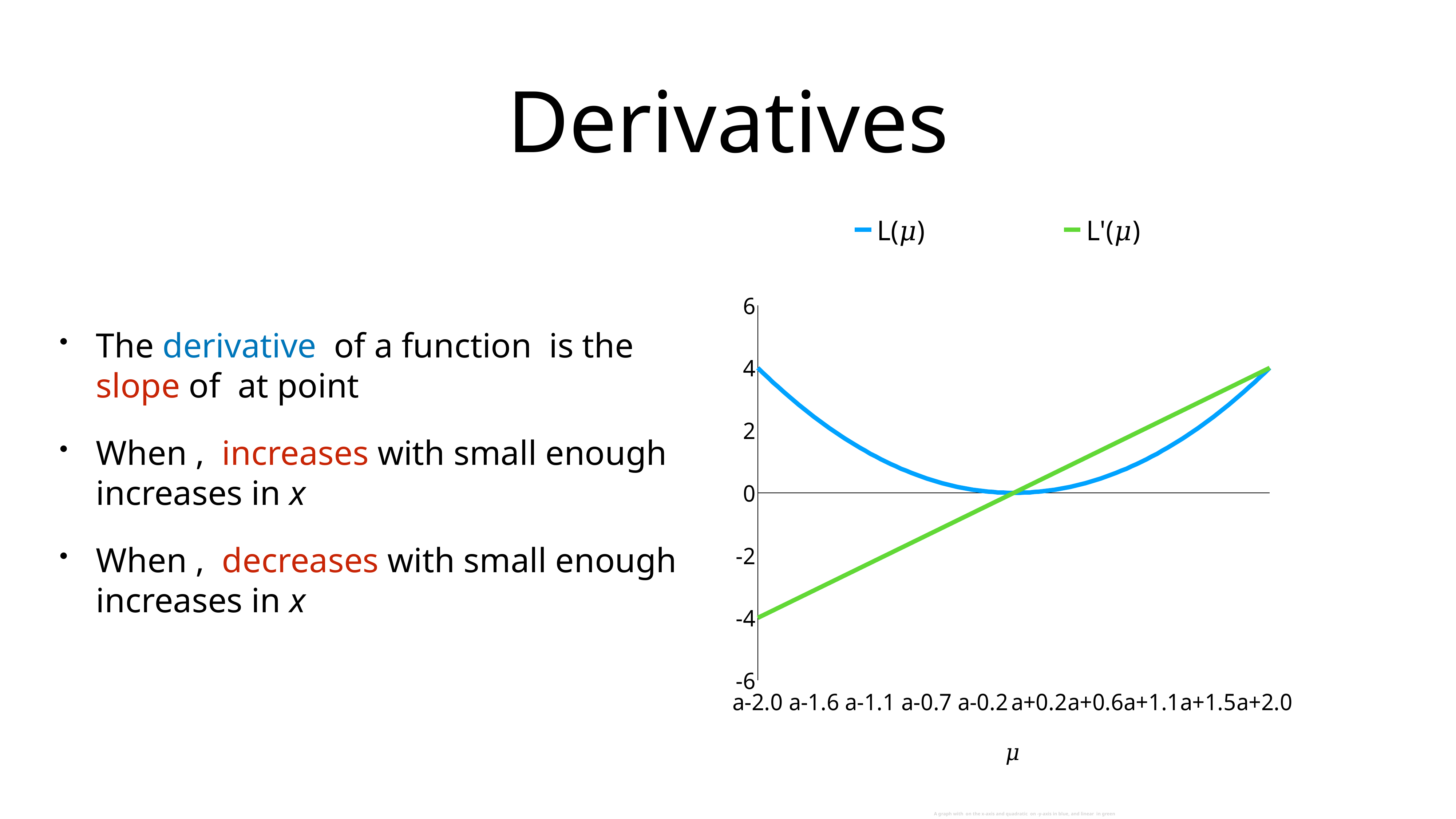
What kind of chart is shown on the slide? line chart What is the value of L'(μ) at a-2.0? -4 Is the value of L'(μ) at a-1.1 greater or less than 0? less What is the value of L'(μ) at a+2.0? 4 What colour is the L(μ) line? blue At a-2.0, which is larger, L(μ) or L'(μ)? L(μ) What is the difference between L(μ) and L'(μ) at a-2.0? 8 Does L'(μ) rise or fall as μ increases along the x axis? rises How many series does the legend list? 2 What is the value of L(μ) at a-2.0? 4 How many labels are shown on the x axis? 10 What are the two series named in the legend? L(μ) and L'(μ)